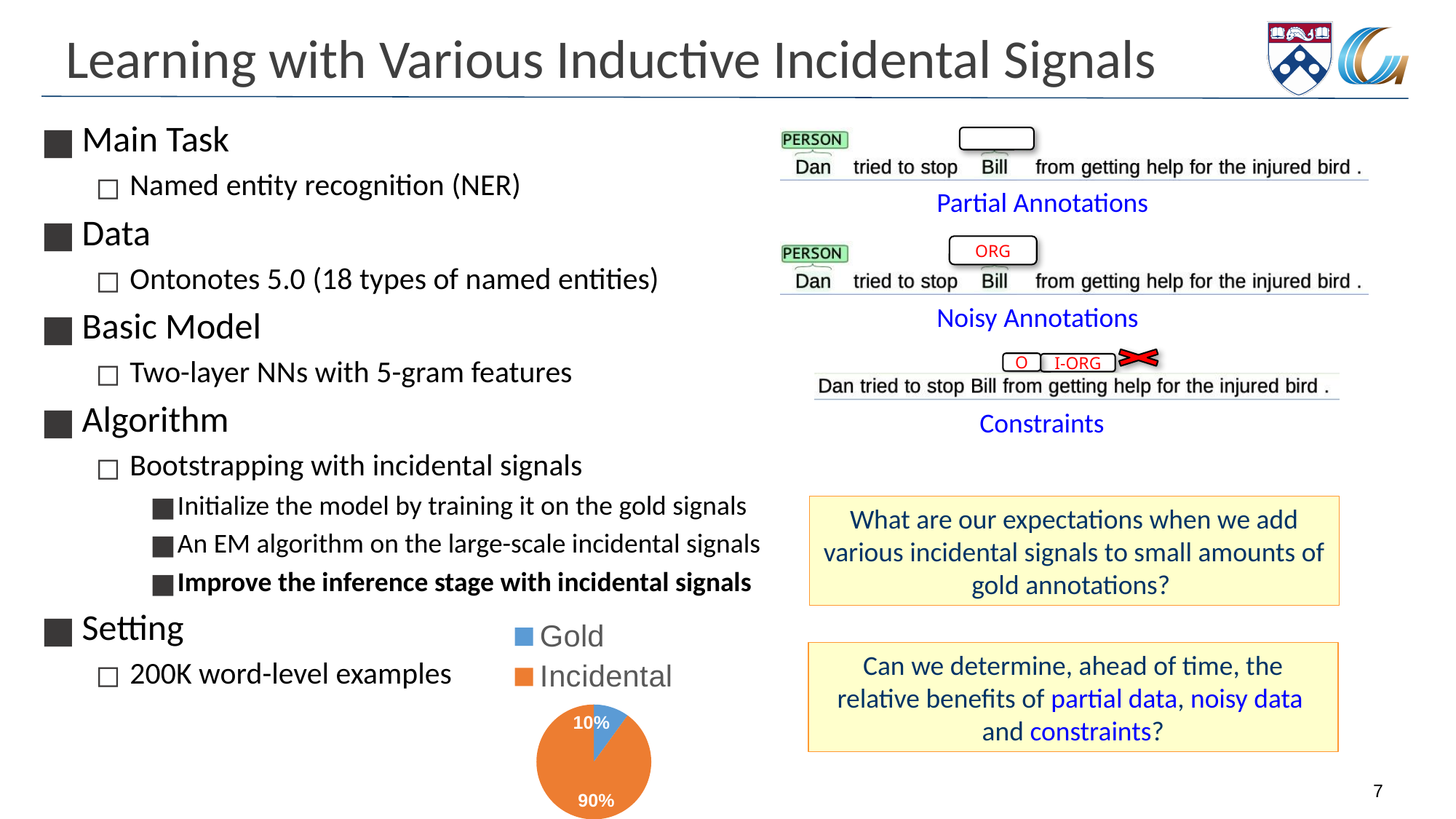
What kind of chart is shown on the slide? pie chart How many entries does the pie chart's legend list? 2 What colour is the Incidental slice in the pie chart? orange What share of the pie chart is labelled Incidental? 90% Which is larger in the pie chart, Gold or Incidental? Incidental What is the difference in percentage points between the Incidental and Gold slices? 80 Which slice of the pie chart is the largest? Incidental What share of the pie chart is labelled Gold? 10% How many slices does the pie chart have? 2 What colour is the Gold slice in the pie chart? blue Which slice of the pie chart is the smallest? Gold